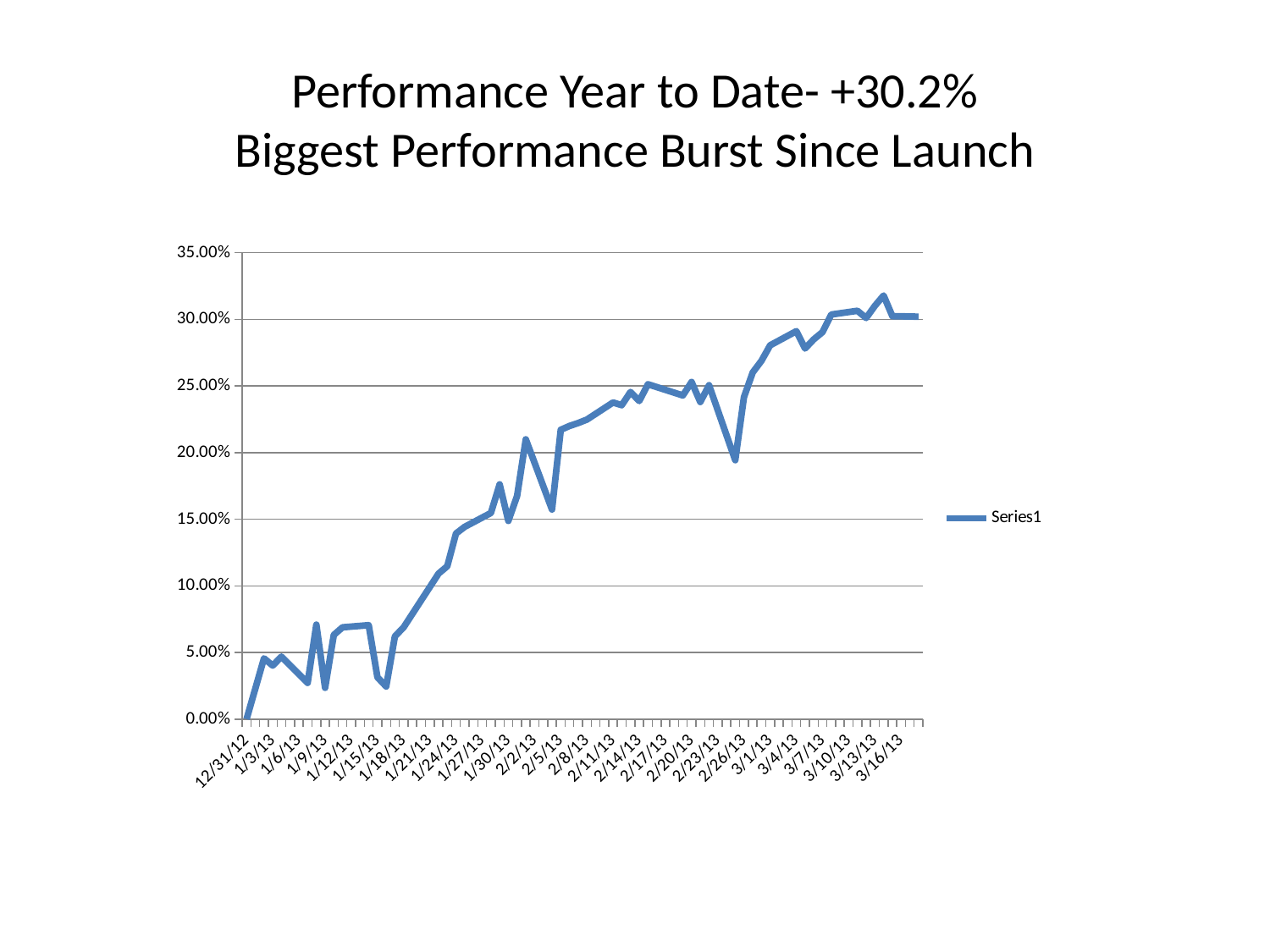
Which date has the lowest value on the chart? 12/31/12 What is the name of the series shown in the legend? Series1 What is the title of the slide above the chart? Performance Year to Date- +30.2% Biggest Performance Burst Since Launch Is the value for 1/3/13 greater or less than 10.00%? less What kind of chart is shown on the slide? line chart What is the value at 12/31/12? 0.00% Is the value for 3/16/13 greater or less than 25.00%? greater How many series does the legend list? 1 Is the value for 1/27/13 greater or less than 10.00%? greater Overall, do the values rise or fall from 12/31/12 to 3/16/13? rise How many date labels are shown on the x axis? 26